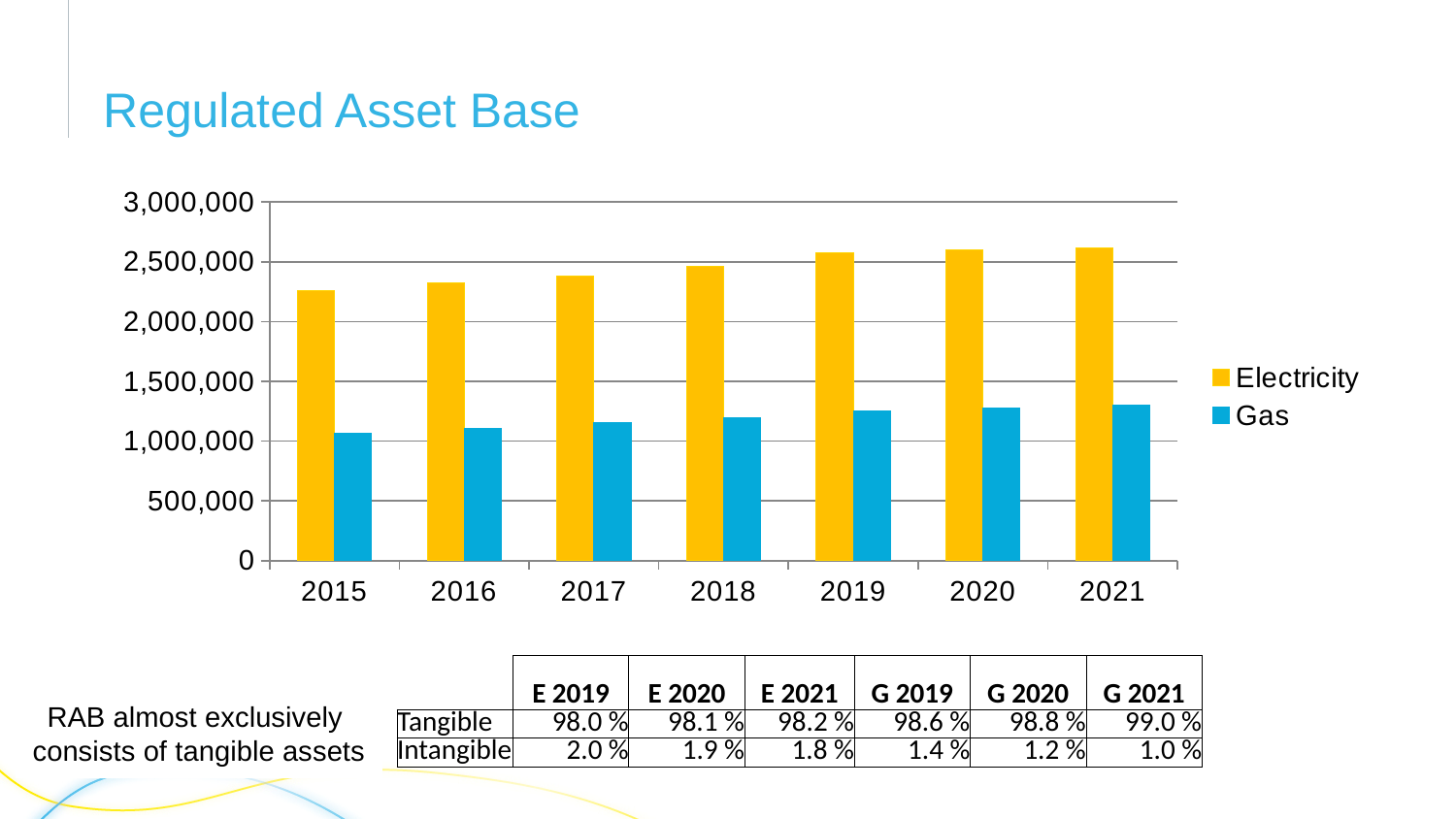
What kind of chart is shown on the slide? bar chart What colour are the Gas bars in the chart? blue Which is larger in 2018, the Electricity value or the Gas value? Electricity Is the Electricity value for 2015 greater or less than 2,000,000? greater Is the Gas value for 2021 greater or less than 1,500,000? less Do the Electricity values rise or fall from 2015 to 2021? rise Is the Electricity value for 2017 greater or less than 2,500,000? less How many series does the chart legend list? 2 Which year has the lowest Gas value? 2015 How many years are shown on the x axis of the chart? 7 Which year has the lowest Electricity value? 2015